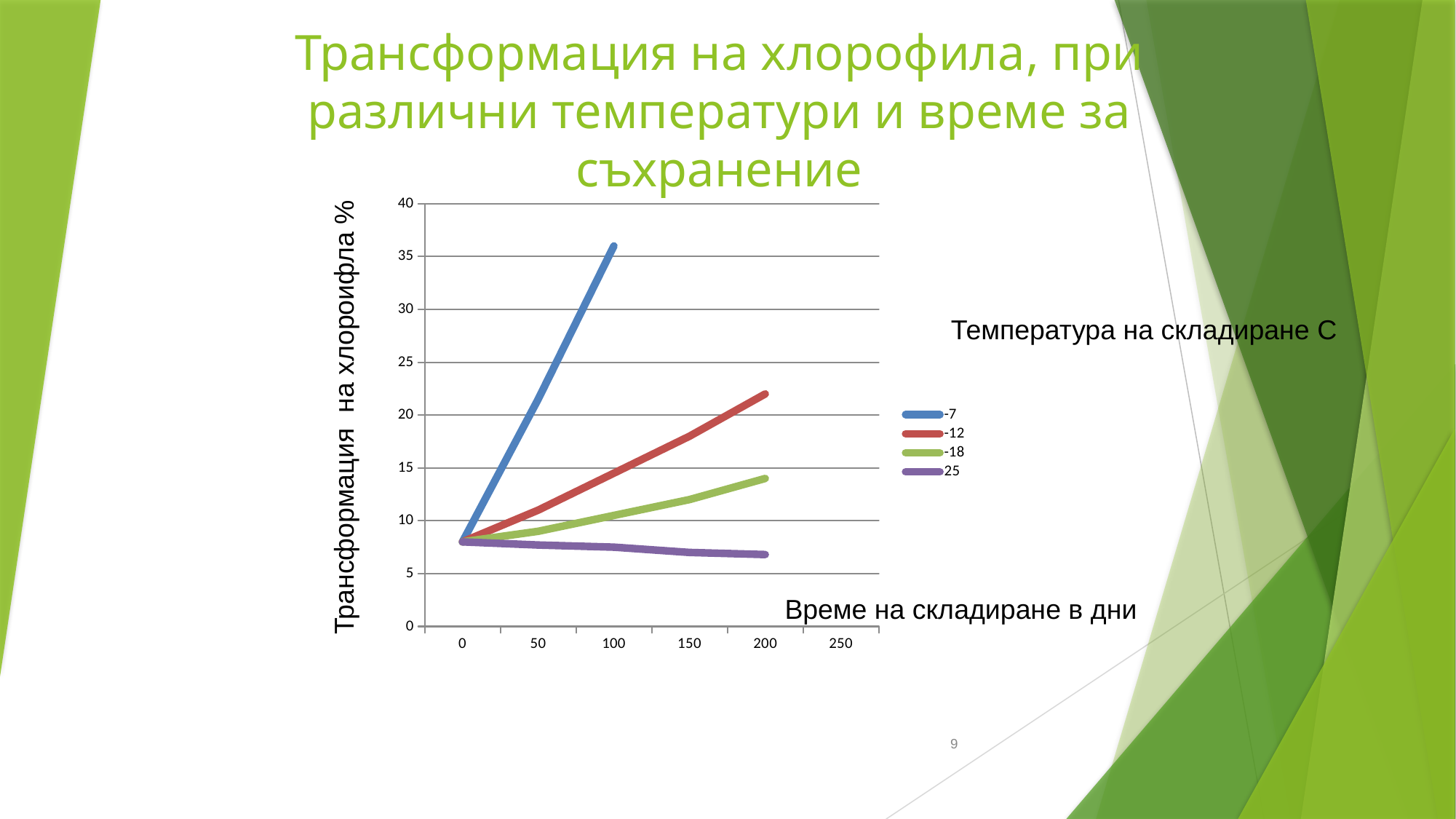
Is the value for the 25 series at 200 days greater or less than 10? less Which series has the lowest value at 200 days? 25 What kind of chart is shown on the slide? line chart Which series reaches the highest transformation value on the chart? -7 At 100 days, which series has the larger value, -7 or -12? -7 How many series does the legend list? 4 Does the 25 series rise or fall as storage time increases? fall Is the value for the -7 series at 100 days greater or less than 30? greater Is the value for the -18 series at 200 days greater or less than 10? greater What is the title of the legend on the chart? Температура на складиране С Does the -12 series rise or fall as storage time increases? rise